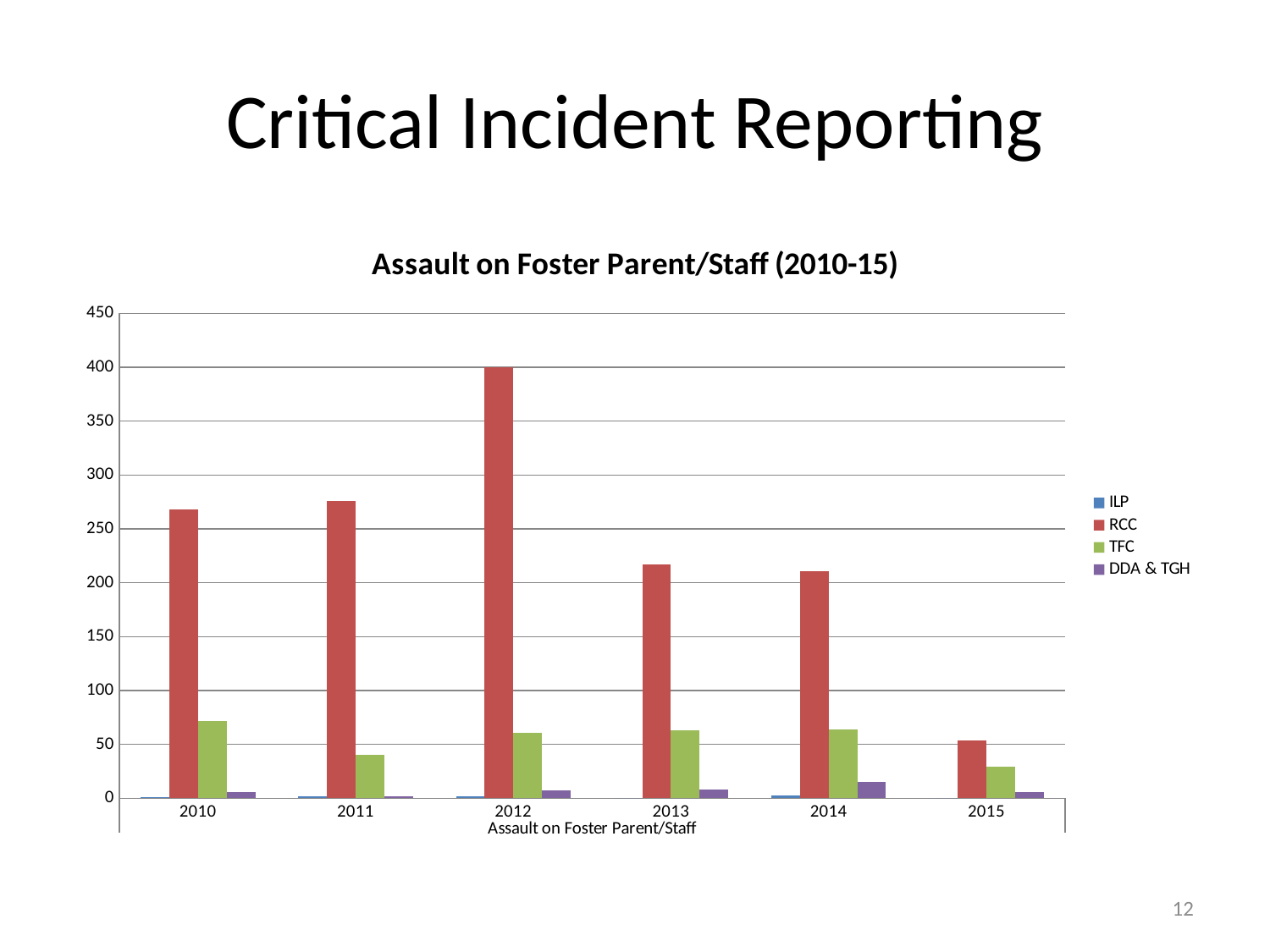
What is the title of the chart? Assault on Foster Parent/Staff (2010-15) How many series does the legend list? 4 Which is larger, the RCC value for 2012 or the RCC value for 2010? 2012 Is the RCC value for 2015 greater or less than 100? less In which year is the RCC value highest? 2012 What type of chart is shown on the slide? bar chart Do the RCC values rise or fall from 2012 to 2015? fall Is the RCC value for 2012 greater or less than 350? greater In which year is the RCC value lowest? 2015 In which year is the TFC value lowest? 2015 How many years are shown on the x axis? 6 Is the TFC value for 2011 greater or less than 50? less